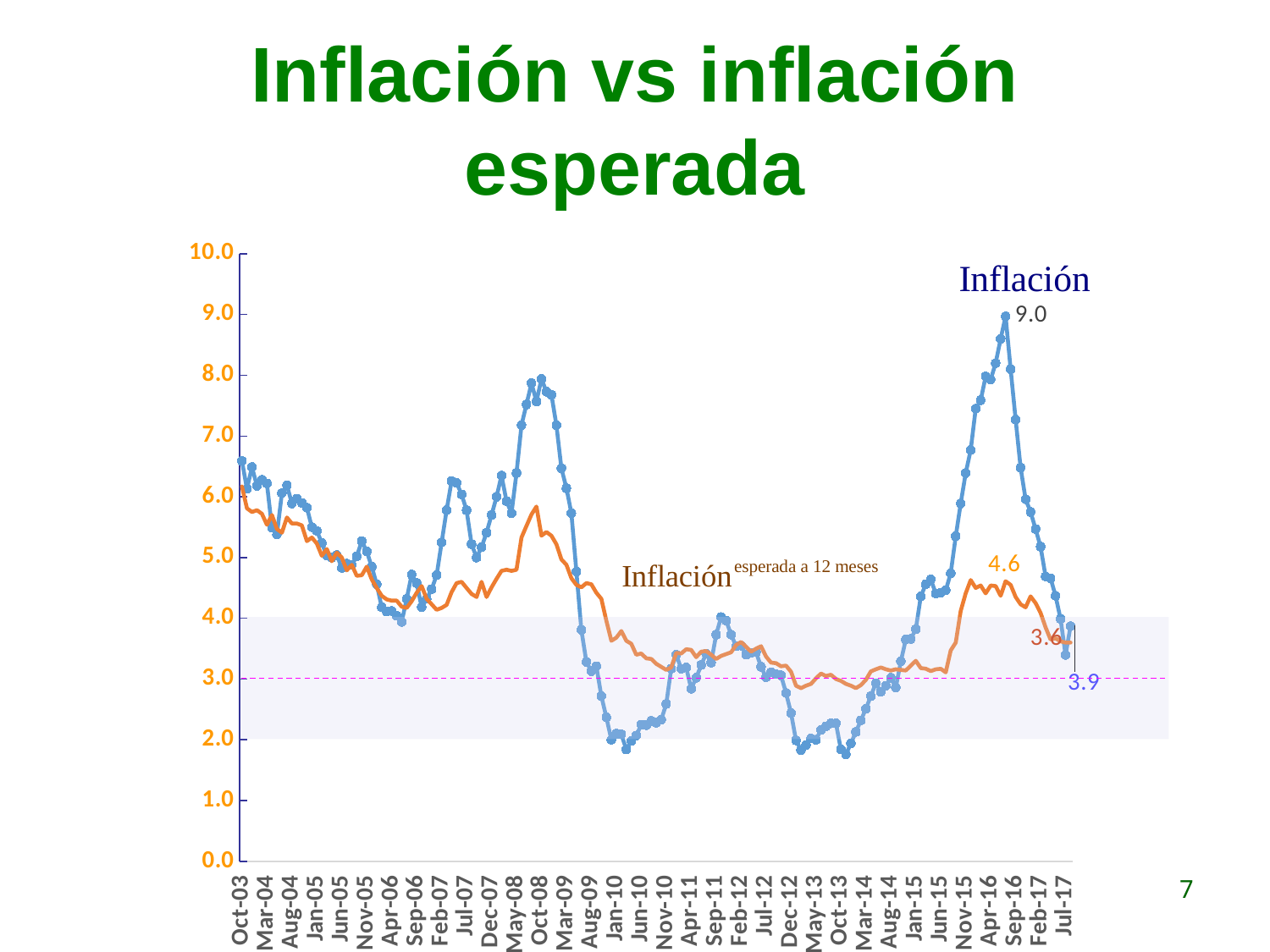
Does the Inflación series rise or fall between Oct-03 and Apr-06? fall How many series are plotted on the chart? 2 At the end of the series, which is larger: Inflación (3.9) or Inflación esperada a 12 meses (3.6)? Inflación What is the last value labelled for the Inflación series (Jul-17)? 3.9 What is the peak value labelled on the Inflación series? 9.0 What kind of chart is shown on the slide? line chart Is the value of Inflación at Oct-03 greater or less than 6.0? greater What is the title of the slide? Inflación vs inflación esperada What is the last value labelled for the Inflación esperada a 12 meses series? 3.6 What is the peak value labelled on the Inflación esperada a 12 meses series? 4.6 What is the difference between the labelled peak of Inflación (9.0) and the labelled peak of Inflación esperada a 12 meses (4.6)? 4.4 Is the value of Inflación at Jan-10 greater or less than 3.0? less